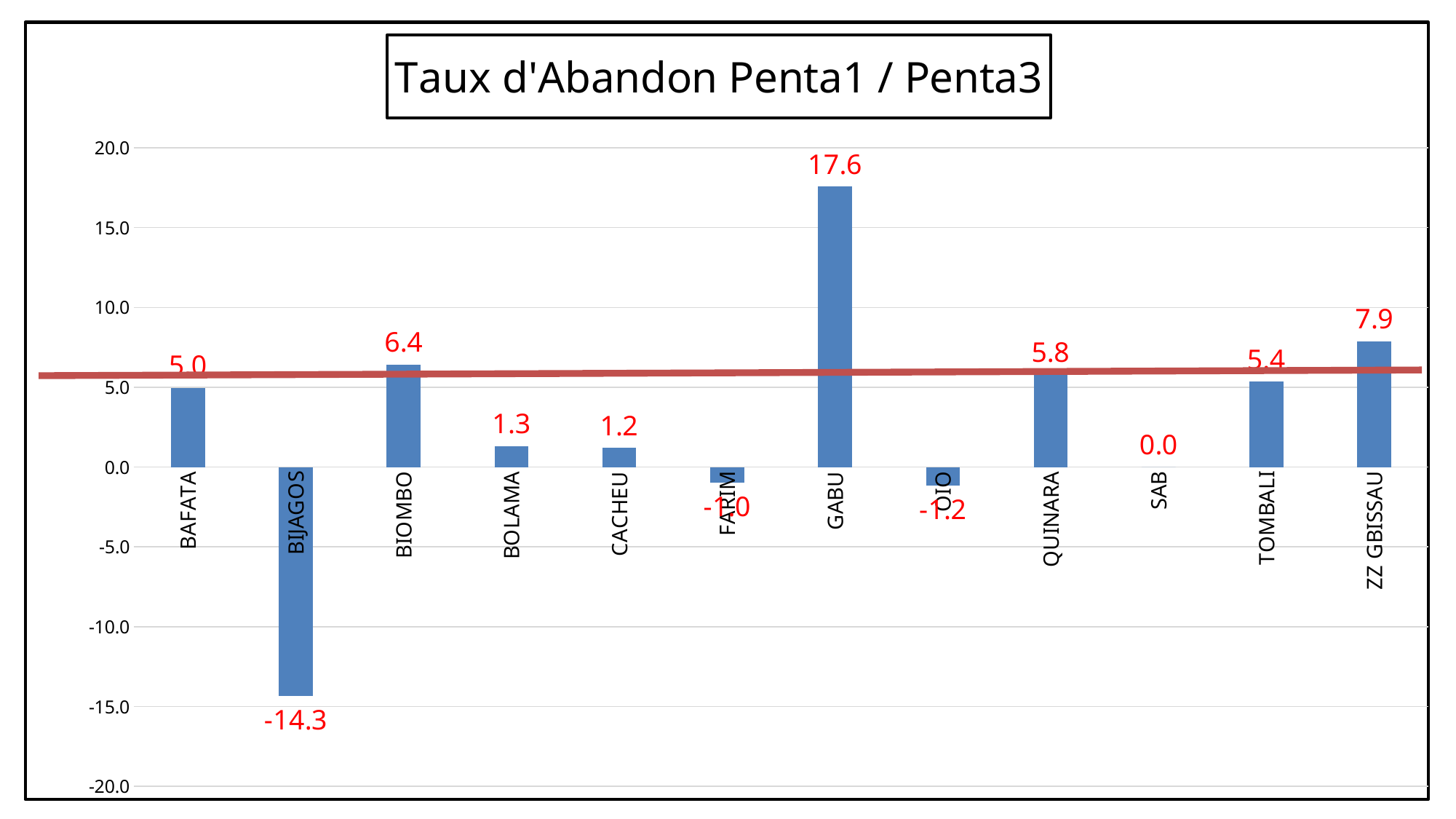
What is the value for ZZ GBISSAU? 7.9 What kind of chart is this? bar chart Which category has the lowest value? BIJAGOS What is the value for SAB? 0.0 Which category has the highest value? GABU What is the value for BIJAGOS? -14.3 What is the title of the chart? Taux d'Abandon Penta1 / Penta3 What is the difference between the values for GABU and ZZ GBISSAU? 9.7 How many categories are shown on the x axis? 12 Which is larger, the value for BIOMBO or the value for QUINARA? BIOMBO Is the value for GABU greater or less than 15.0? greater What is the value for GABU? 17.6